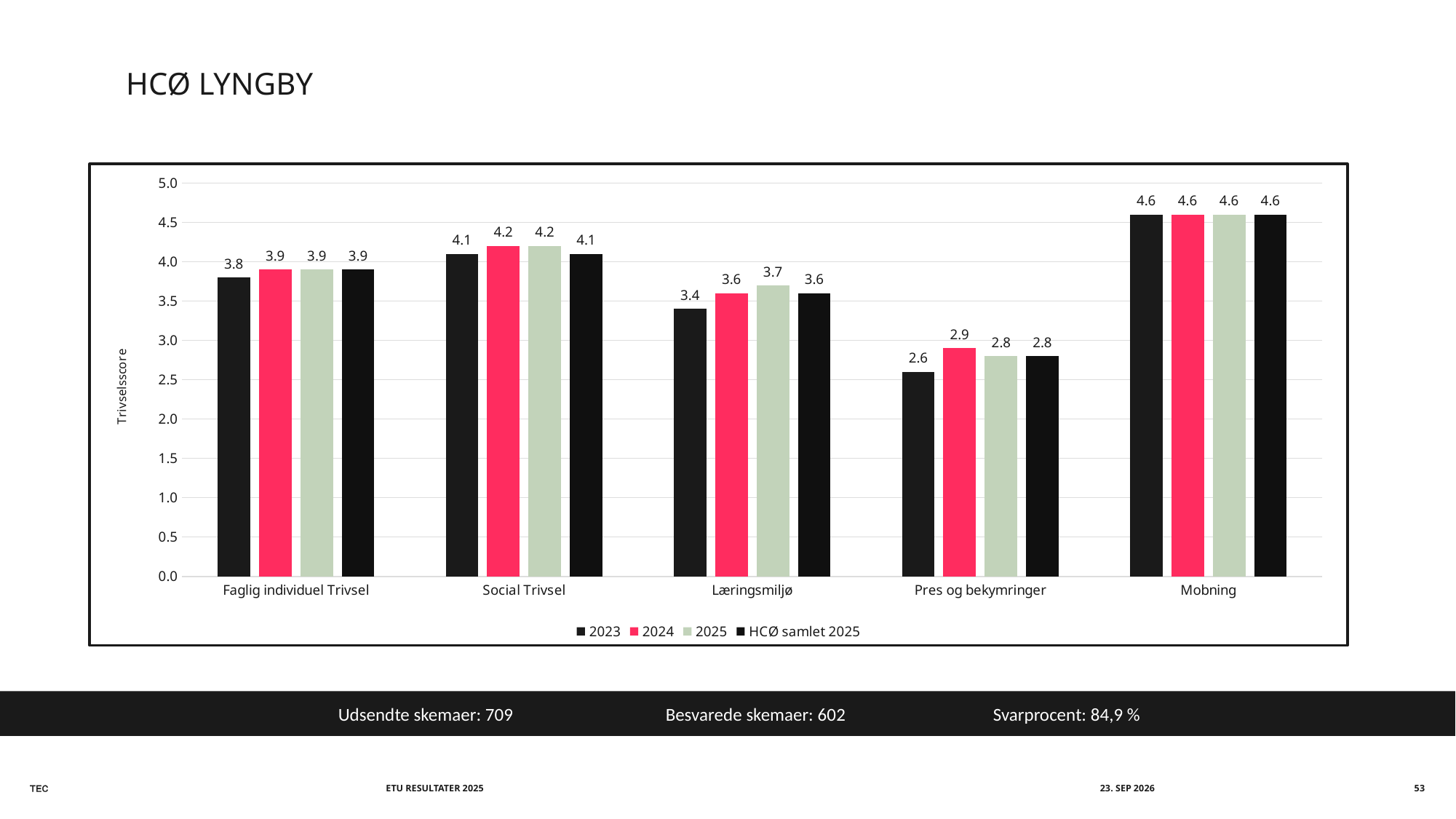
What is the 2025 value for Læringsmiljø? 3.7 What is the 2024 value for Social Trivsel? 4.2 What kind of chart is shown on the slide? Bar chart What is the 2023 value for Pres og bekymringer? 2.6 Which category has the highest 2025 value? Mobning What is the label of the y axis? Trivselsscore How many series does the legend list? 4 What is the HCØ samlet 2025 value for Faglig individuel Trivsel? 3.9 What is the difference between the 2025 and 2023 values for Læringsmiljø? 0.3 Which is larger for Pres og bekymringer, the 2024 value or the 2023 value? 2024 Which category has the lowest 2023 value? Pres og bekymringer How many categories are shown on the x axis? 5